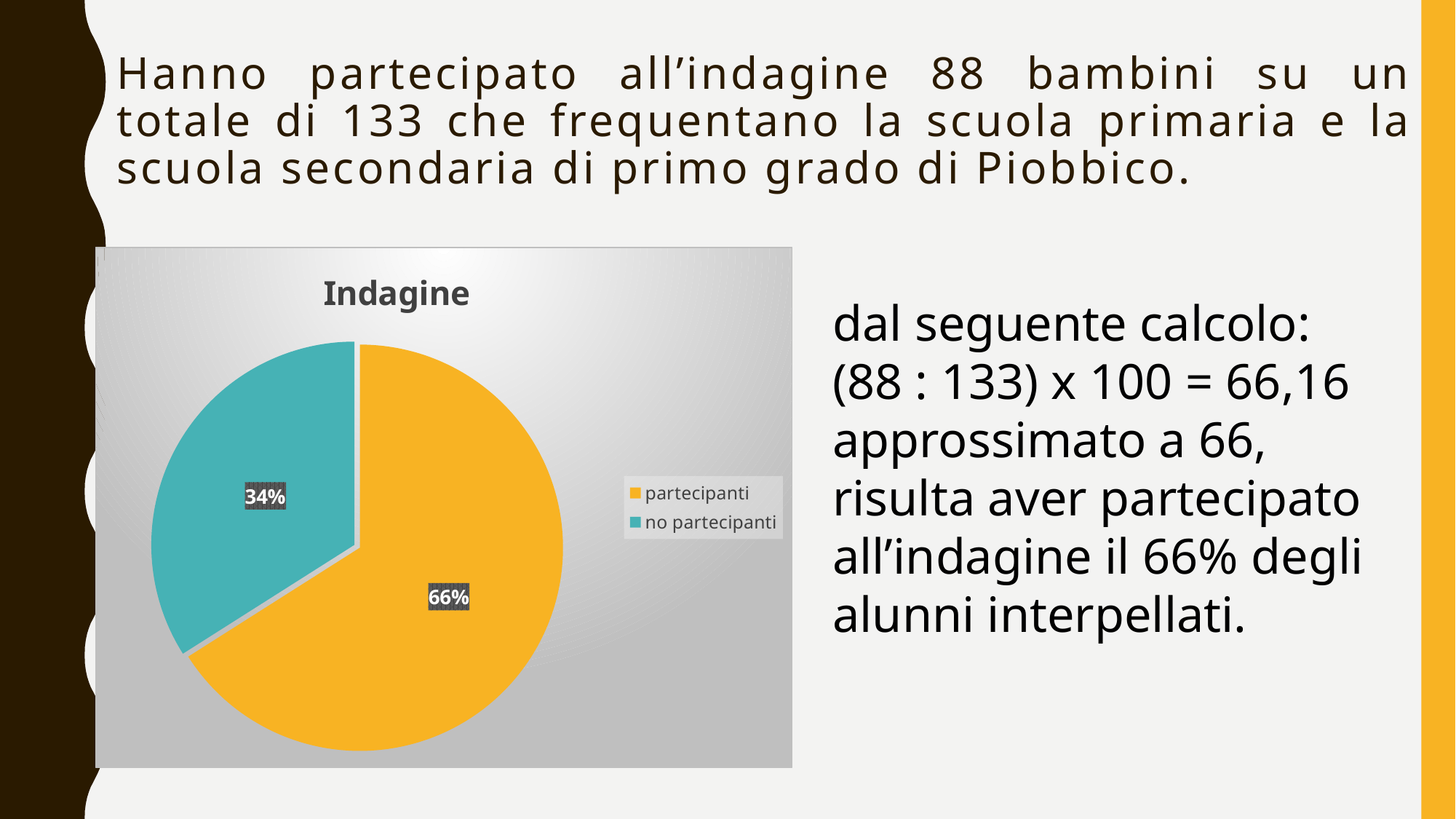
What kind of chart is shown on the slide? pie chart How many slices does the pie chart have? 2 Which slice of the pie is the largest? partecipanti What is the difference in percentage points between the "partecipanti" and "no partecipanti" slices? 32 What percentage of the pie is labelled for "no partecipanti"? 34% How many entries does the legend list? 2 Which slice of the pie is the smallest? no partecipanti What colour is the "no partecipanti" slice? teal What share of the pie does the "partecipanti" slice represent? 66% What percentage of the pie is labelled for "partecipanti"? 66% What is the title of the chart? Indagine Which slice is larger, "partecipanti" or "no partecipanti"? partecipanti